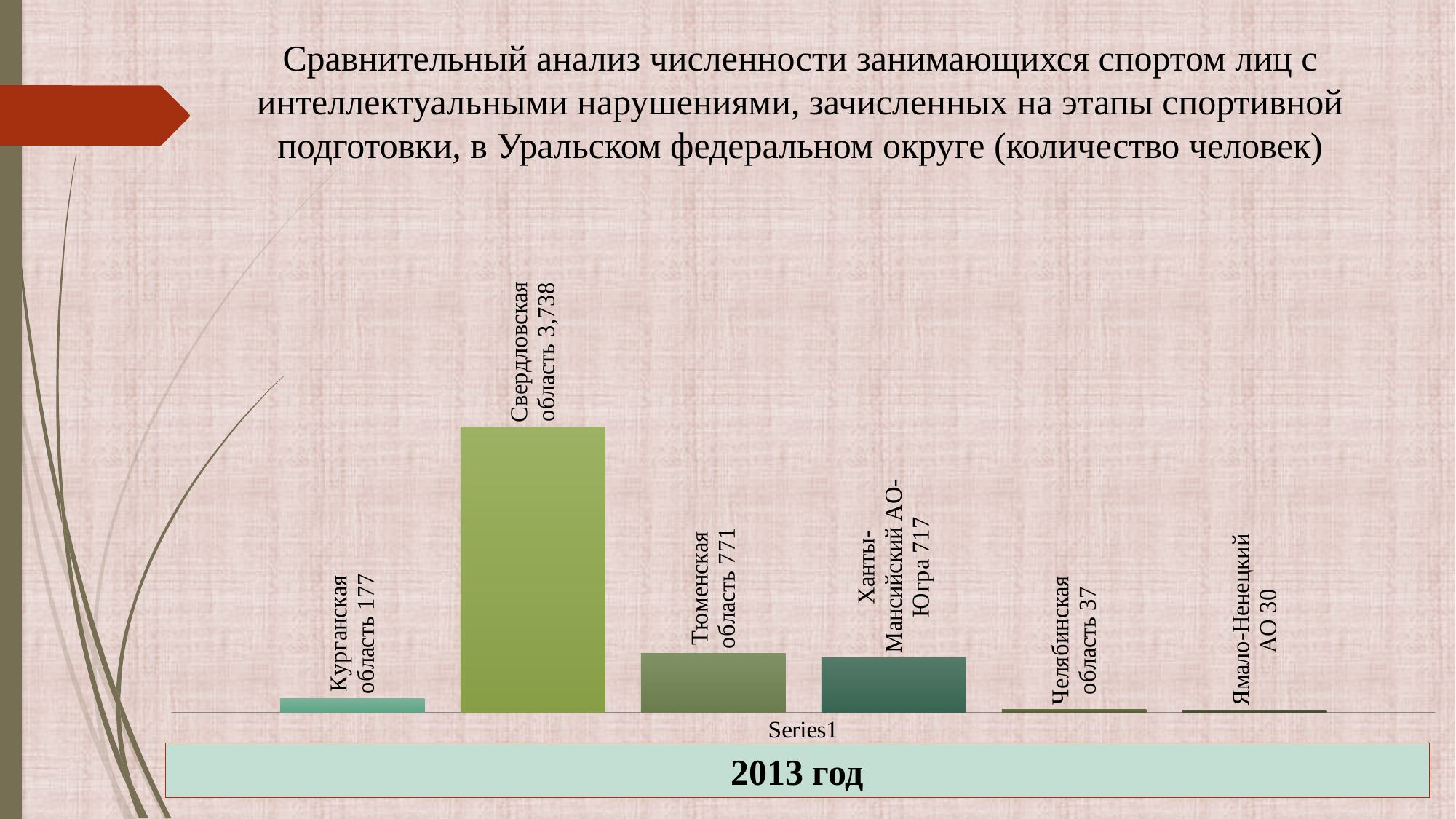
What is the value for Ханты-Мансийский АО-Югра? 717 How many regions are shown in the chart? 6 What kind of chart is shown on the slide? Bar chart Which region has the lowest value? Ямало-Ненецкий АО What year is shown in the box below the chart? 2013 год What is the difference between the values for Тюменская область and Ханты-Мансийский АО-Югра? 54 Which is larger, the value for Курганская область or the value for Челябинская область? Курганская область What is the value for Курганская область? 177 What is the value for Ямало-Ненецкий АО? 30 What is the value for Тюменская область? 771 What is the value for Свердловская область? 3,738 Which region has the highest value? Свердловская область